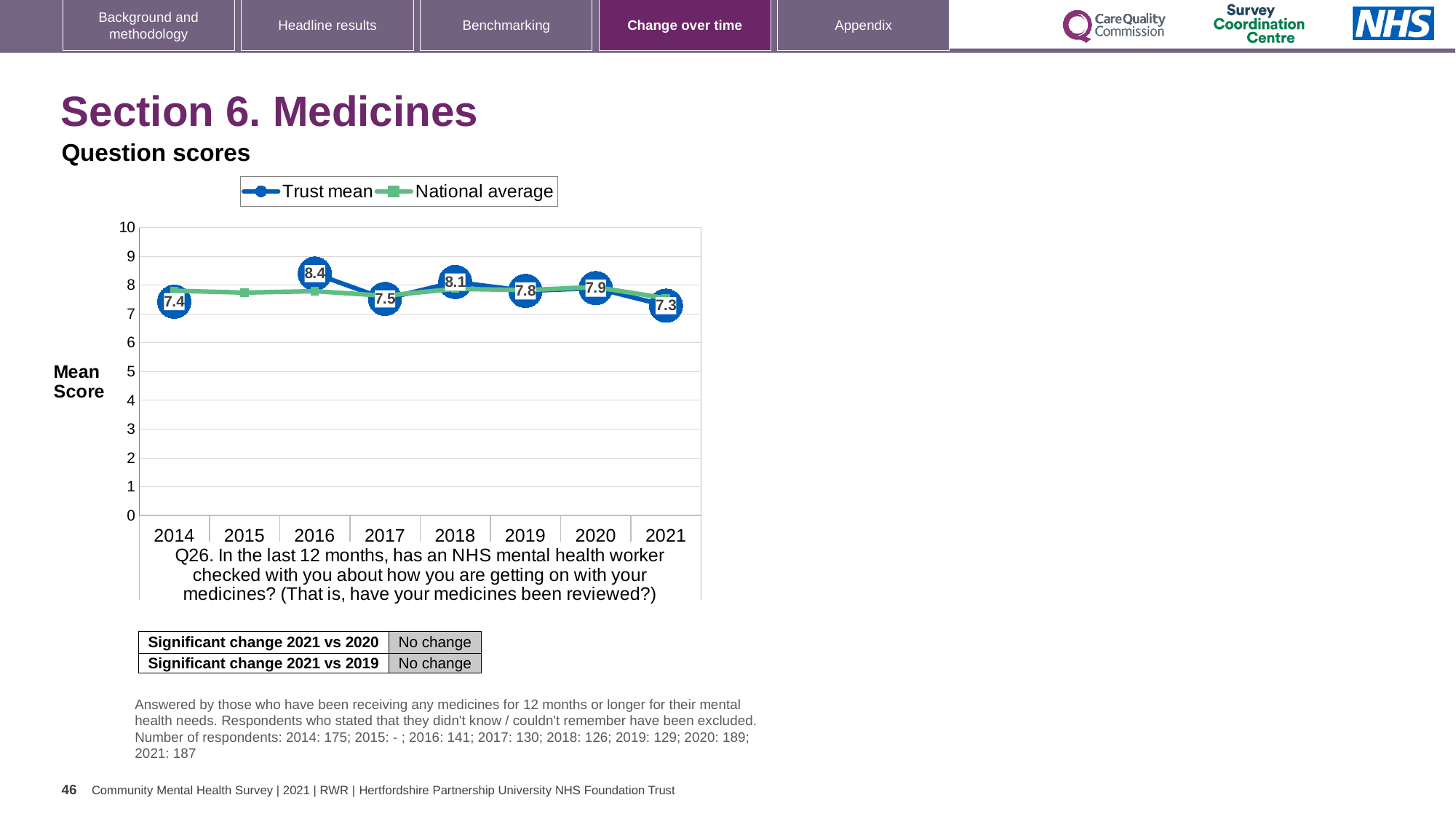
How many series does the legend list? 2 What is the Trust mean score for 2018? 8.1 In which year is the Trust mean score lowest? 2021 What is the difference between the Trust mean scores for 2016 and 2021? 1.1 How many years are shown on the x axis of the chart? 8 In which year is the Trust mean score highest? 2016 What kind of chart is shown on the slide? Line chart Is the National average value for 2019 greater or less than 7? greater Which year has the larger Trust mean score, 2017 or 2020? 2020 What is the Trust mean score for 2021? 7.3 What is the Trust mean score for 2016? 8.4 Does the Trust mean score rise or fall from 2020 to 2021? Fall